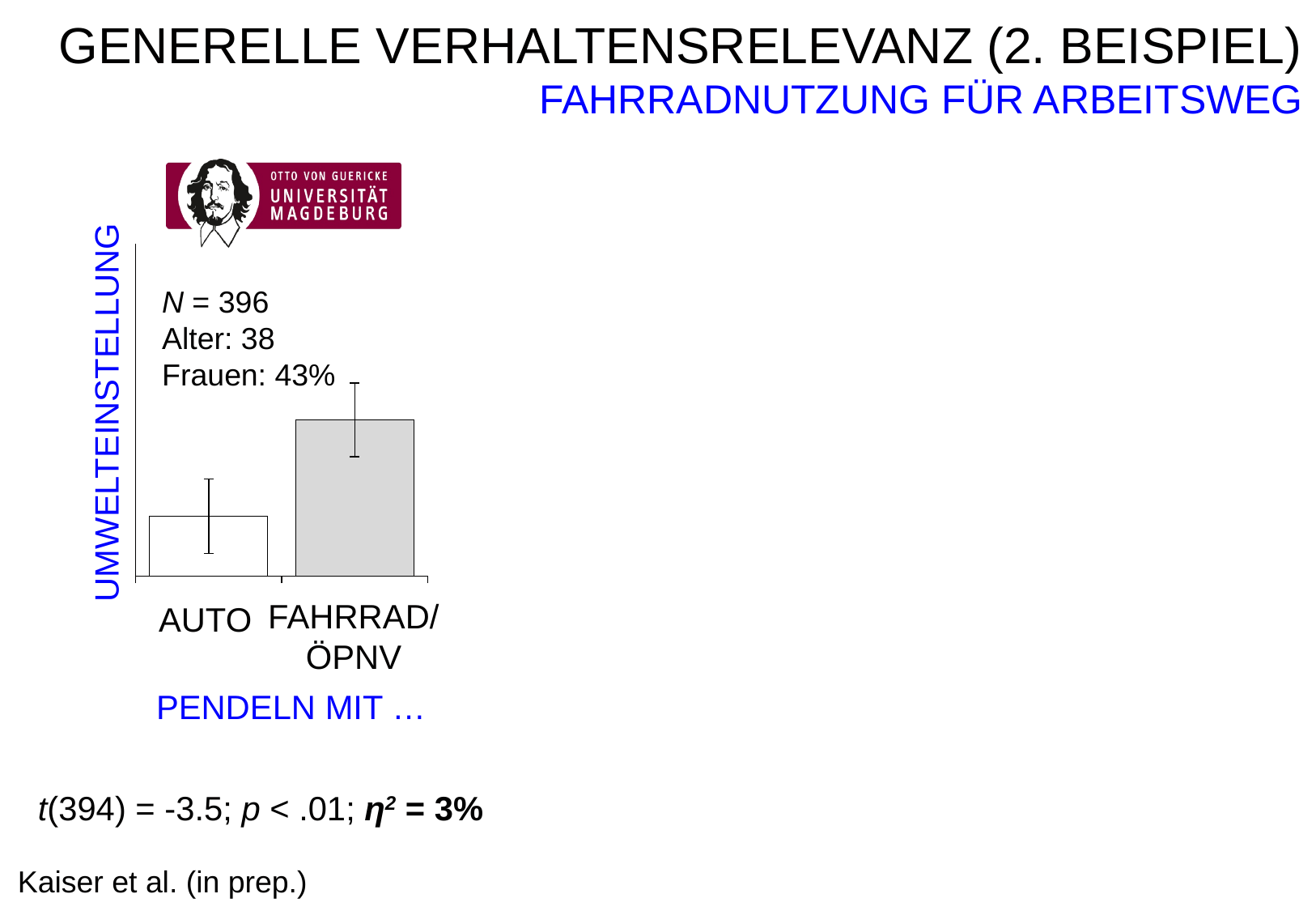
How many categories are plotted on the x axis of the chart? 2 What kind of chart is shown on the slide? bar chart What is the label of the x axis of the chart? PENDELN MIT … Which bar is taller, AUTO or FAHRRAD/ÖPNV? FAHRRAD/ÖPNV Which category has the highest bar in the chart? FAHRRAD/ÖPNV Do the bar values rise or fall from AUTO to FAHRRAD/ÖPNV? rise Which category has the lowest bar in the chart? AUTO What is the label of the y axis of the chart? UMWELTEINSTELLUNG